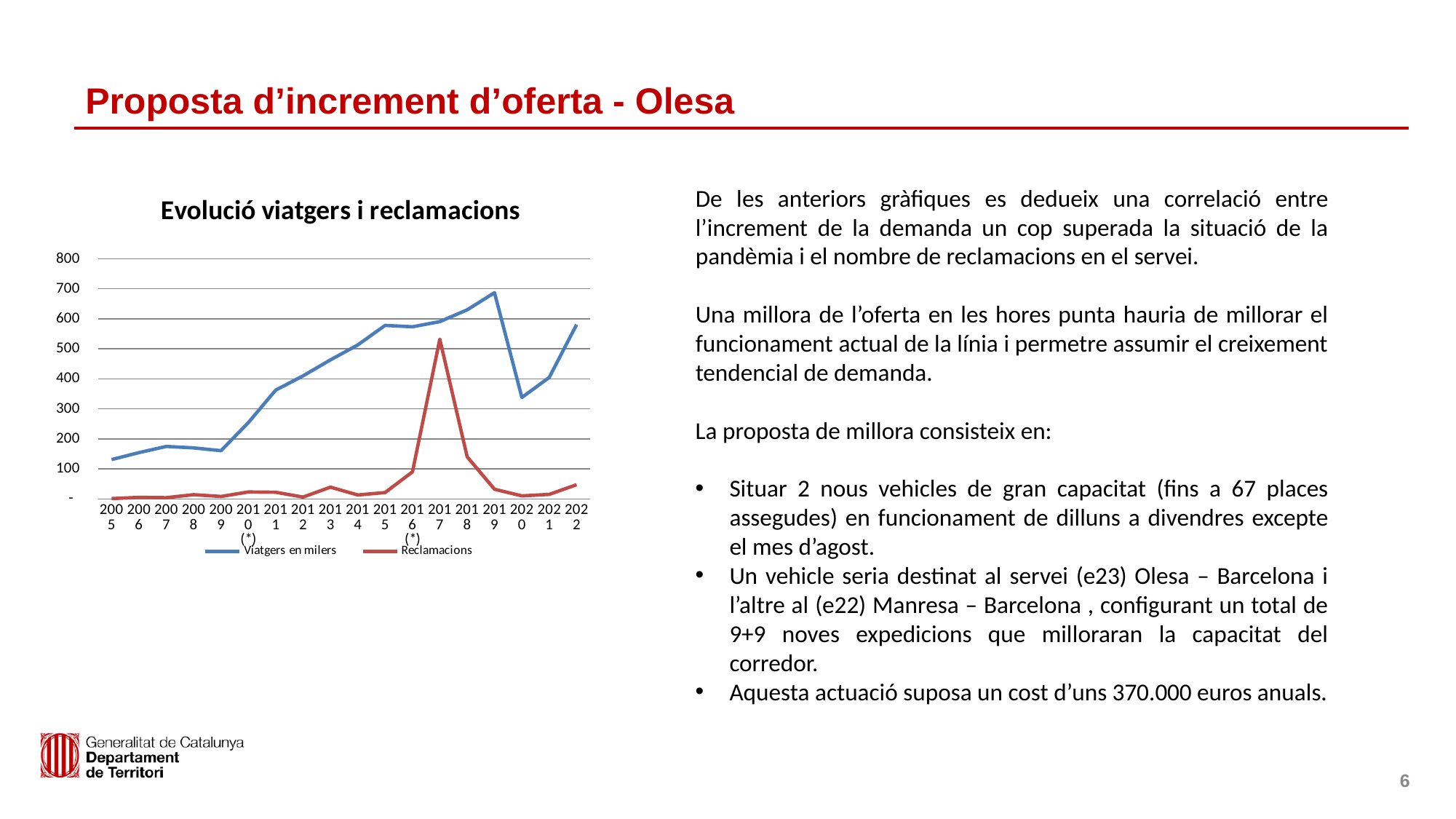
How many series does the legend of the chart list? 2 What is the title of the chart? Evolució viatgers i reclamacions Is the value of Viatgers en milers in 2020 greater or less than 400? less In which year does the Viatgers en milers series reach its highest value? 2019 In which year is the Viatgers en milers series at its lowest value? 2005 In which year does the Reclamacions series reach its highest value? 2017 Which year has the higher value for Viatgers en milers, 2019 or 2020? 2019 Is the value of Reclamacions in 2017 greater or less than 400? greater Which colour is used for the Reclamacions series? red How many years are plotted along the x axis of the chart? 18 Is the value of Viatgers en milers in 2019 greater or less than 600? greater What type of chart is shown on the slide? line chart